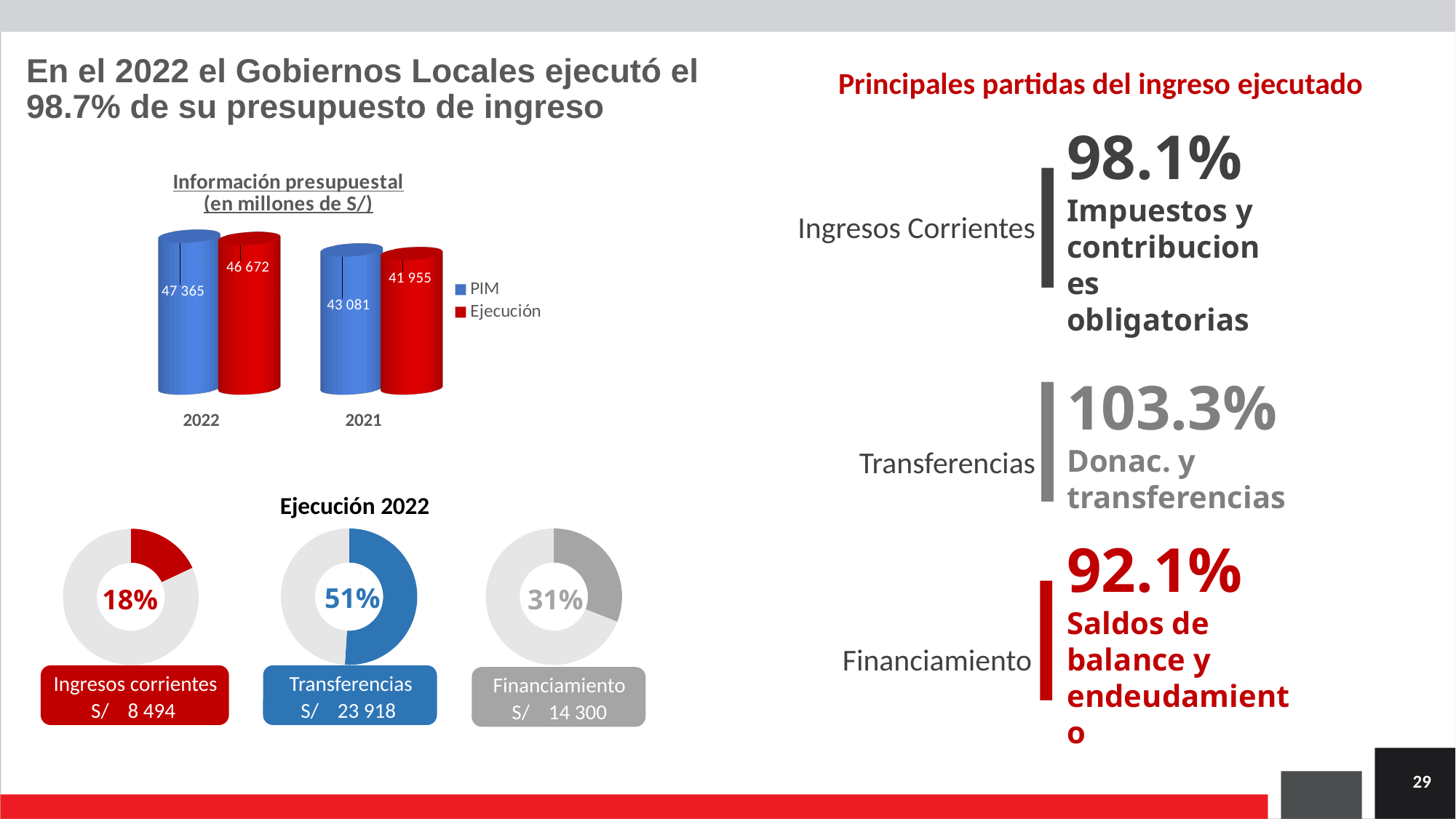
In the 'Información presupuestal' bar chart, how many series does the legend list? 2 In the 'Información presupuestal' bar chart, which is larger: PIM in 2022 or PIM in 2021? PIM in 2022 In the 'Ejecución 2022' donut charts, what is the value shown for Financiamiento? S/ 14 300 In the 'Información presupuestal' bar chart, which colour represents Ejecución? Red What kind of chart is the 'Información presupuestal' chart? Bar chart In the 'Ejecución 2022' donut charts, what share is shown for Transferencias? 51% In the 'Información presupuestal' bar chart, what is the Ejecución value for 2022? 46 672 In the 'Ejecución 2022' donut charts, which category has the smallest share? Ingresos corrientes In the 'Información presupuestal' bar chart, what is the Ejecución value for 2021? 41 955 In the 'Información presupuestal' bar chart, what is the difference between PIM and Ejecución in 2021? 1 126 In the 'Información presupuestal' bar chart, what is the PIM value for 2022? 47 365 In the 'Información presupuestal' bar chart, what is the difference between PIM and Ejecución in 2022? 693